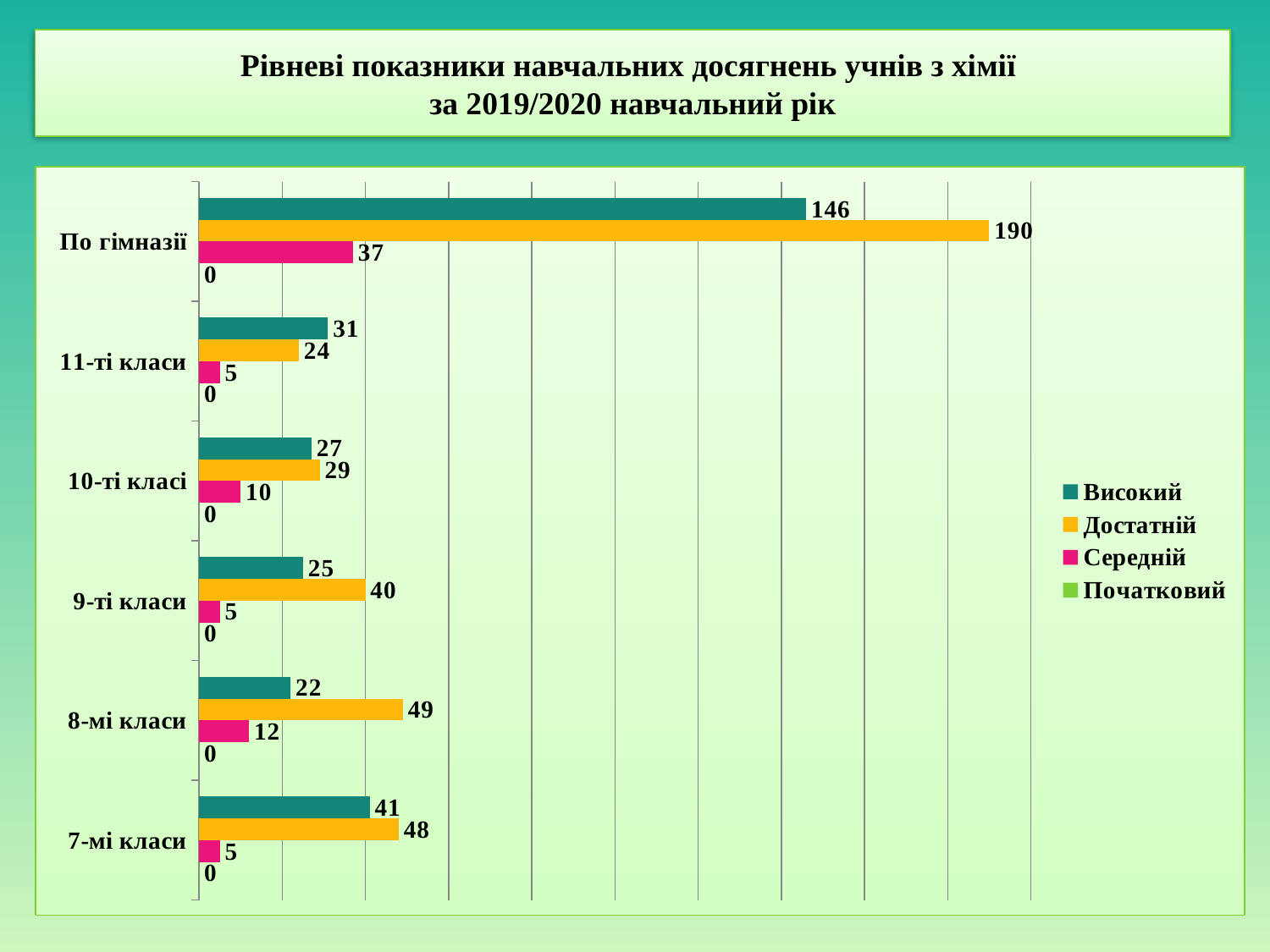
What is the title of the chart? Рівневі показники навчальних досягнень учнів з хімії за 2019/2020 навчальний рік What is the value of Достатній for По гімназії? 190 What is the difference between the Достатній and Високий values for По гімназії? 44 What is the value of Високий for 7-мі класи? 41 How many categories are shown on the vertical axis? 6 Which class category has the lowest Високий value? 8-мі класи What is the value of Середній for 8-мі класи? 12 How many series does the legend list? 4 What is the value of Початковий for 9-ті класи? 0 Which class category has the highest Достатній value (excluding По гімназії)? 8-мі класи Which is larger for 11-ті класи: Високий or Достатній? Високий What kind of chart is shown on the slide? bar chart